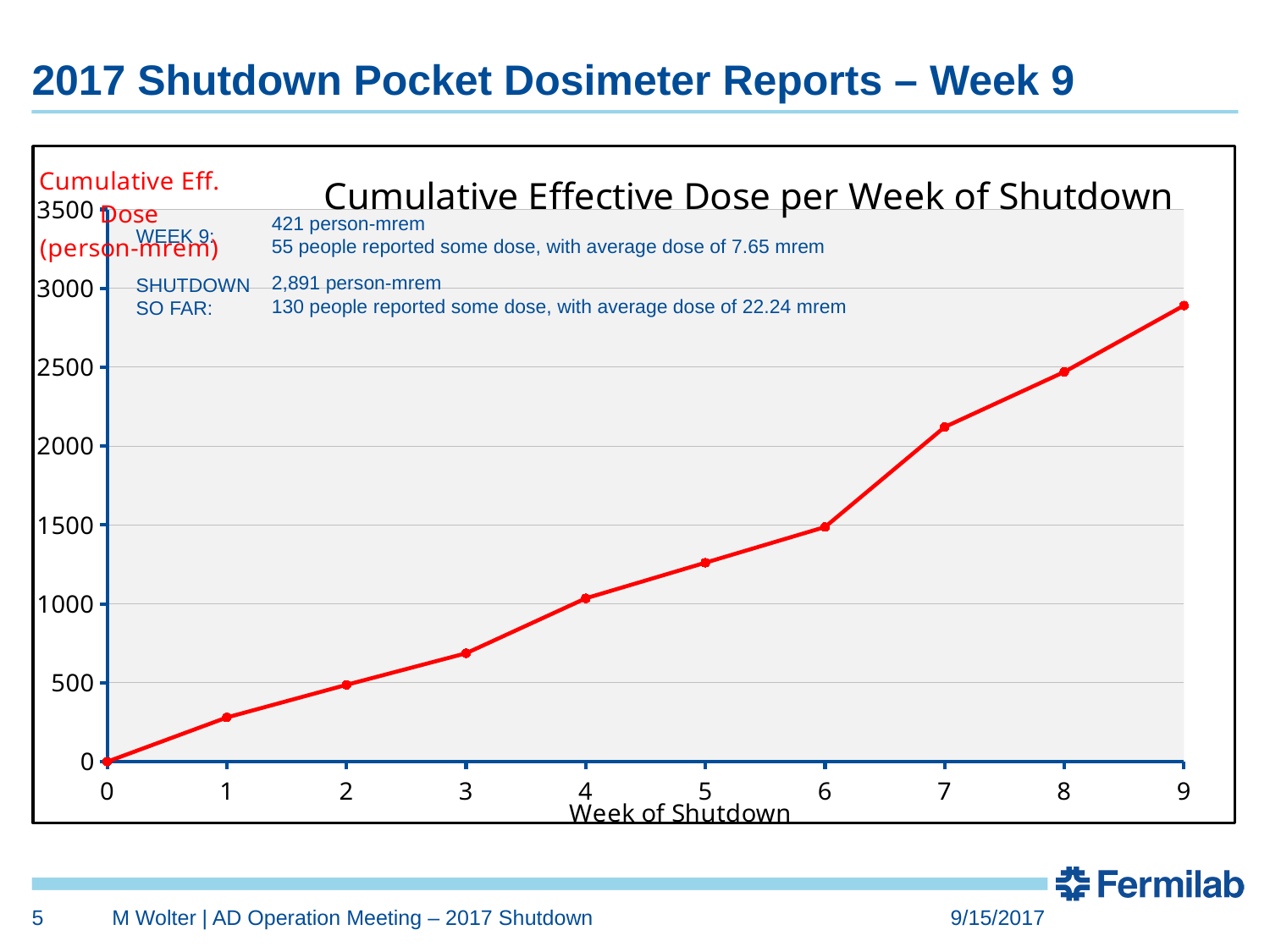
Which is larger, the value for week 7 or the value for week 5? week 7 What is the label of the x axis? Week of Shutdown Is the value for week 7 greater or less than 2000? greater What is the title of the chart? Cumulative Effective Dose per Week of Shutdown What is the cumulative effective dose at week 0? 0 How many data points are plotted on the line? 10 Is the value for week 3 greater or less than 500? greater Which week has the highest cumulative effective dose? 9 Is the value for week 1 greater or less than 500? less What kind of chart is shown on the slide? line chart Do the values rise or fall as the week of shutdown increases? rise Which week has the lowest cumulative effective dose? 0